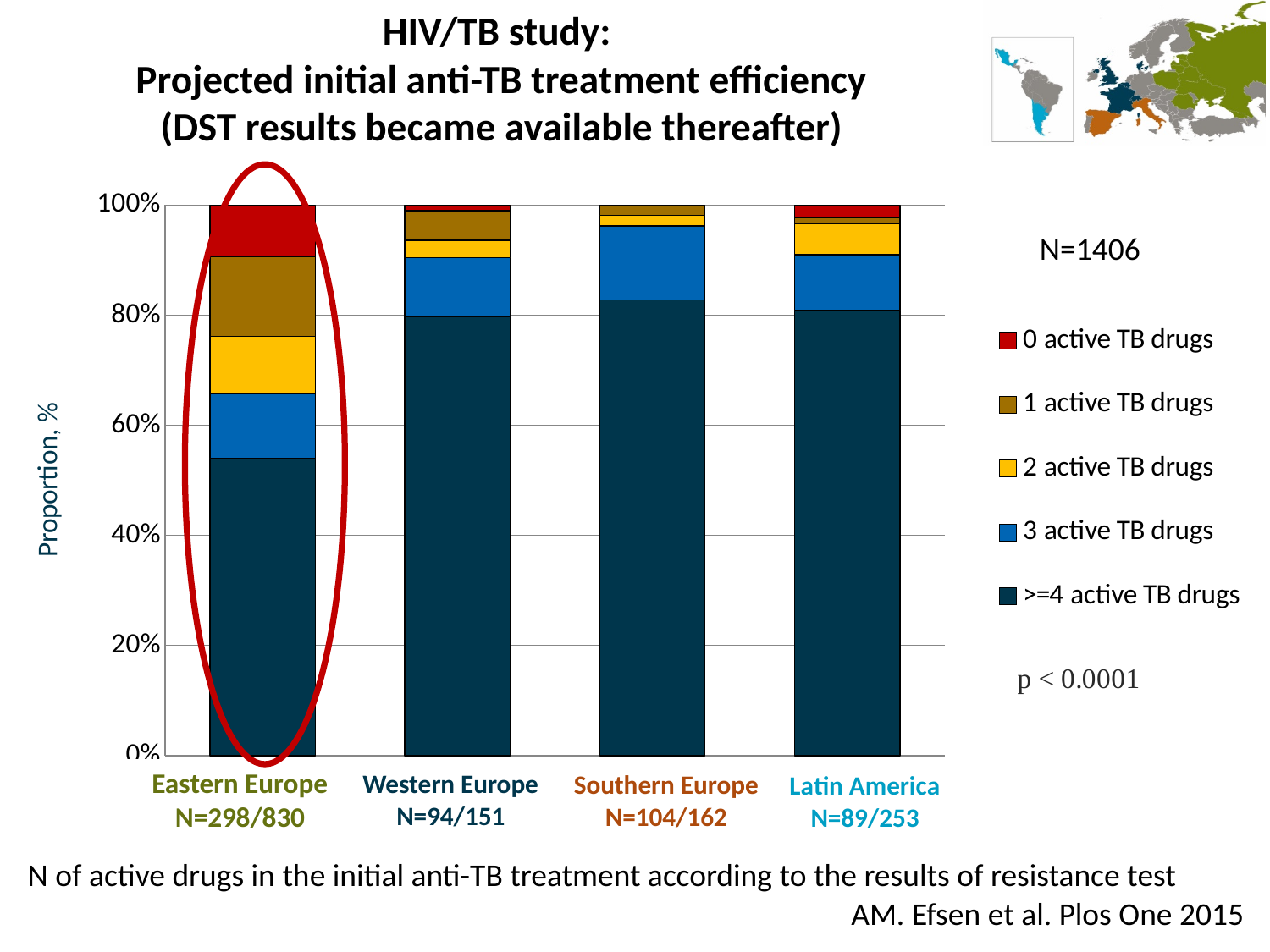
Which region has the lowest proportion of patients with >=4 active TB drugs? Eastern Europe What is the sample size label shown under the Eastern Europe bar? N=298/830 Is the proportion of patients with >=4 active TB drugs in Eastern Europe greater or less than 60%? less What is the total N reported next to the chart? N=1406 How many series does the chart legend list? 5 Which region has a larger proportion of patients with >=4 active TB drugs, Eastern Europe or Latin America? Latin America Is the proportion of patients with >=4 active TB drugs in Western Europe greater or less than 60%? greater Which region has the highest proportion of patients with 0 active TB drugs? Eastern Europe What kind of chart is shown on the slide? stacked bar chart Is the proportion of patients with >=4 active TB drugs in Southern Europe greater or less than 60%? greater How many regions (categories) are shown on the x axis of the chart? 4 Which region has a larger proportion of patients with 1 active TB drug, Eastern Europe or Southern Europe? Eastern Europe